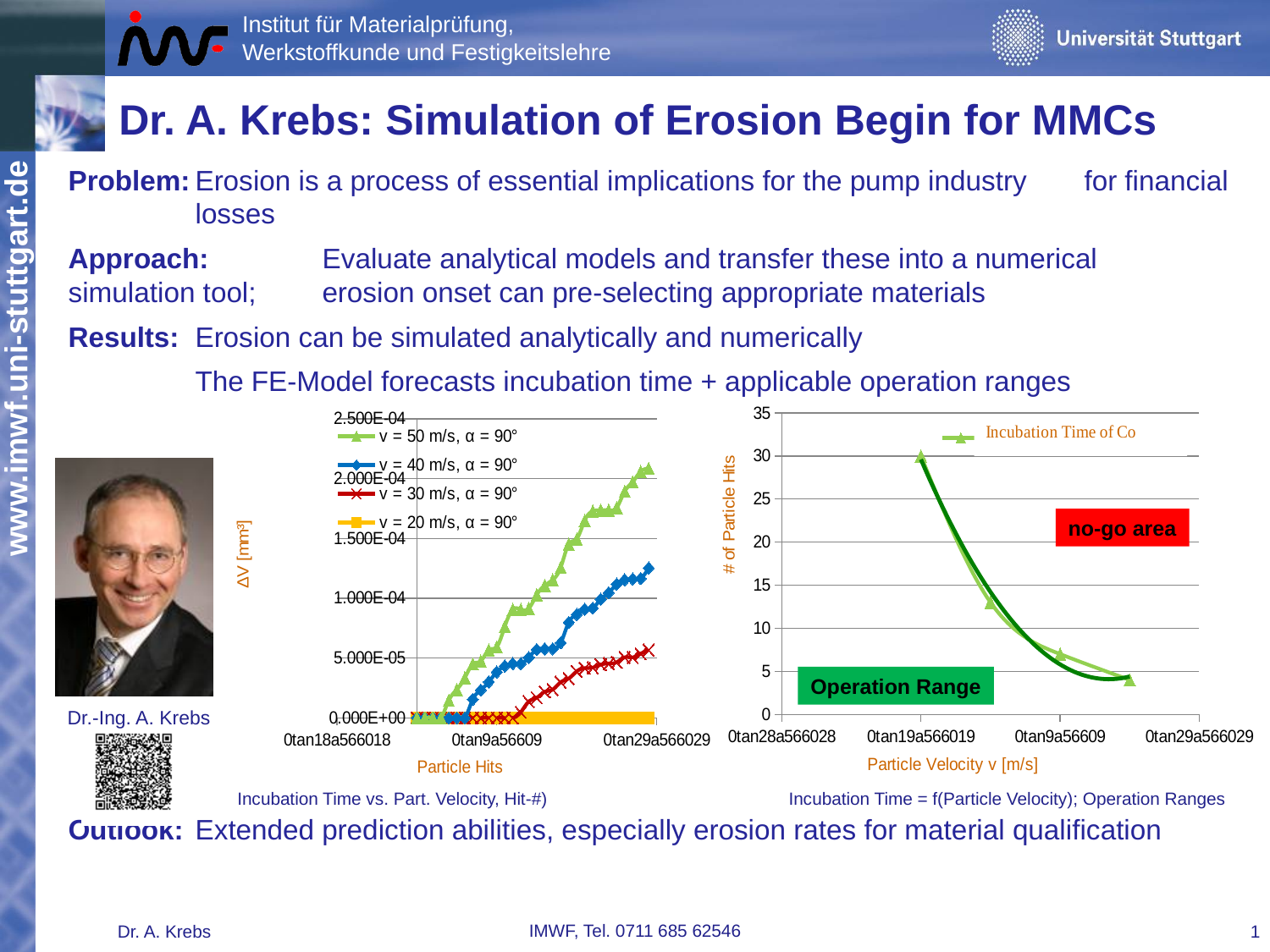
In the left chart, do the ΔV values of the v = 50 m/s series rise or fall as Particle Hits increase? rise In the left chart, which series reaches the highest ΔV value? v = 50 m/s, α = 90° How many series does the legend of the left chart list? 4 In the left chart, is the final value of the v = 40 m/s series greater or less than 1.500E-04? less In the left chart, at the right end of the x axis, which series has the larger ΔV: v = 40 m/s or v = 30 m/s? v = 40 m/s, α = 90° What is the legend entry of the right chart? Incubation Time of Co In the left chart, which series stays lowest, remaining at zero across the whole range? v = 20 m/s, α = 90° In the right chart, does the number of particle hits rise or fall as particle velocity increases? fall In the right chart, is the lowest plotted value greater or less than 10? less In the right chart, is the highest plotted value greater or less than 25? greater What kind of chart is the left chart (ΔV vs. Particle Hits)? line chart